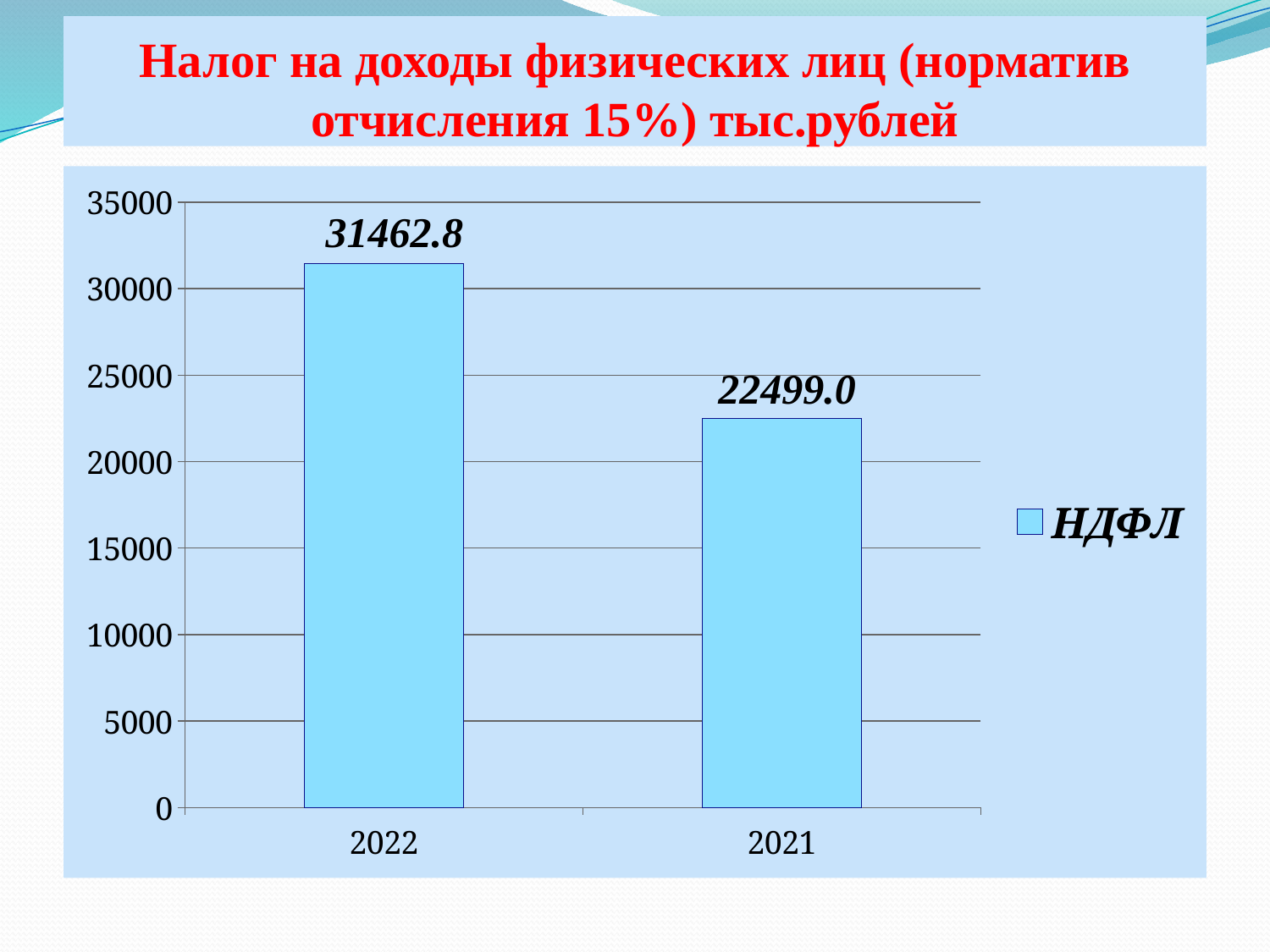
Is the value for 2022 greater or less than 30000? greater What is the difference between the values for 2022 and 2021? 8963.8 Is the value for 2021 greater or less than 25000? less How many series does the legend list? 1 What is the value for 2022? 31462.8 What is the name of the series in the legend? НДФЛ What is the value for 2021? 22499.0 Which year has the highest value? 2022 What kind of chart is shown? bar chart Which is larger, the value for 2022 or the value for 2021? 2022 Which year has the lowest value? 2021 How many categories are shown on the x axis? 2